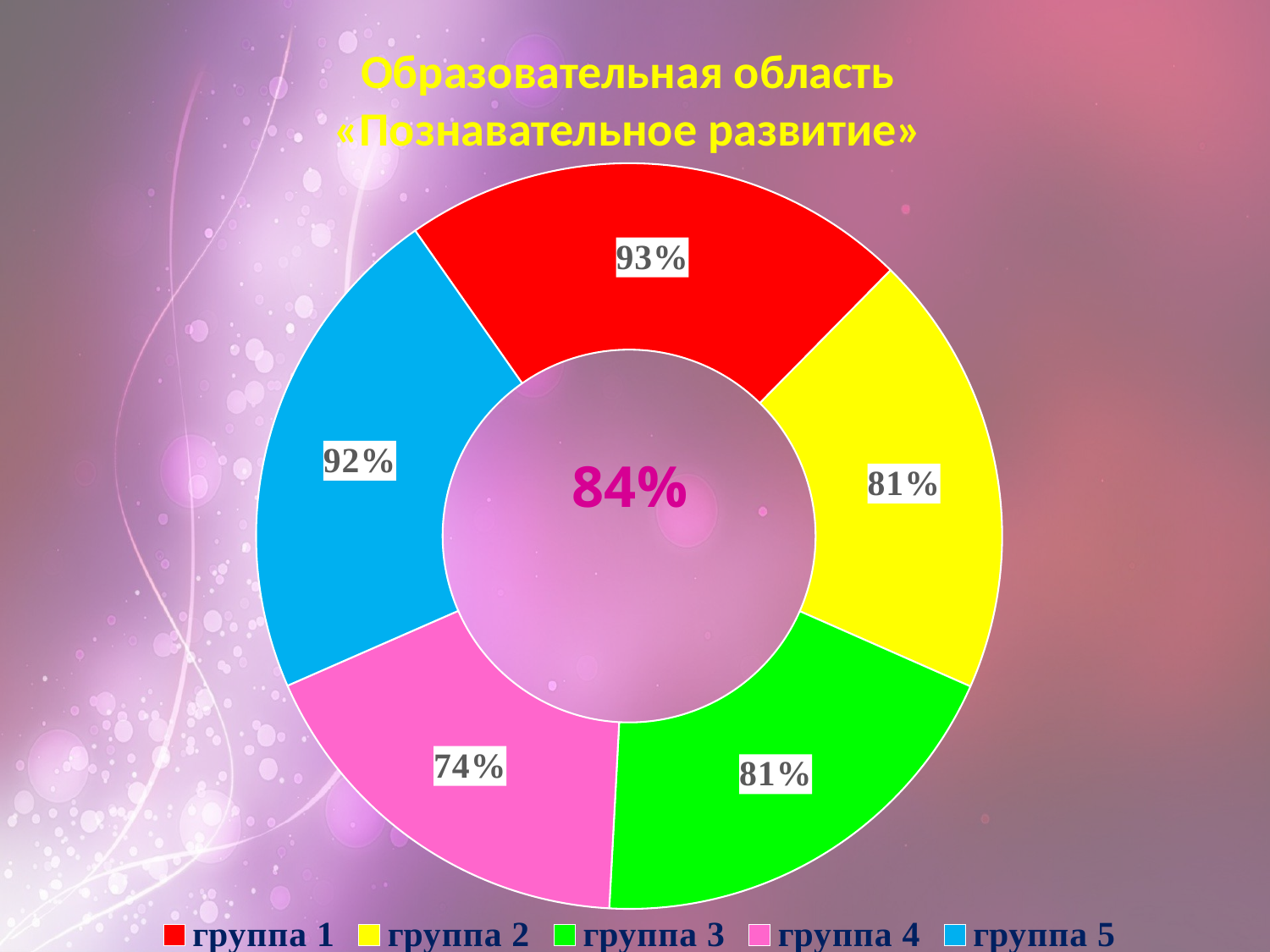
Which is larger, the value for группа 5 or the value for группа 3? группа 5 Which group has the lowest value? группа 4 How many entries does the legend list? 5 What kind of chart is shown on the slide? Doughnut (pie) chart What is the difference between the values for группа 1 and группа 4? 19% How many groups are shown in the chart? 5 What value is shown for группа 1? 93% What value is shown for группа 2? 81% What value is printed in the centre of the chart? 84% What value is shown for группа 4? 74% What value is shown for группа 5? 92% Which group has the highest value? группа 1